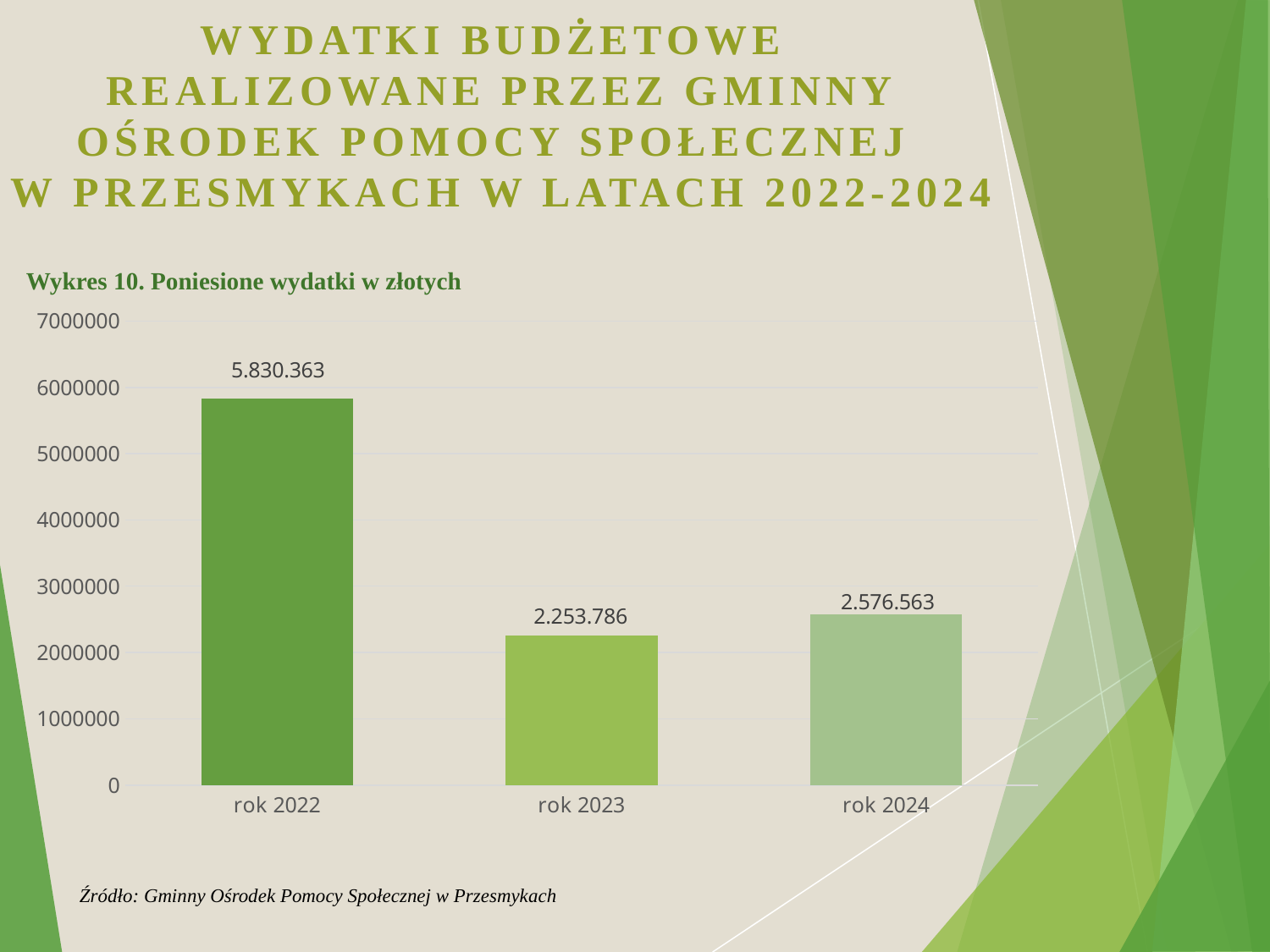
Which is larger, the value for rok 2023 or rok 2024? rok 2024 Is the value for rok 2022 greater or less than 5000000? greater What is the value for rok 2022? 5.830.363 Which year has the highest value? rok 2022 What is the difference between the values for rok 2024 and rok 2023? 322.777 What is the difference between the values for rok 2022 and rok 2023? 3.576.577 What is the value for rok 2023? 2.253.786 How many years are shown on the chart? 3 What is the title of the chart? Wykres 10. Poniesione wydatki w złotych What kind of chart is shown on the slide? bar chart Which year has the lowest value? rok 2023 What is the value for rok 2024? 2.576.563